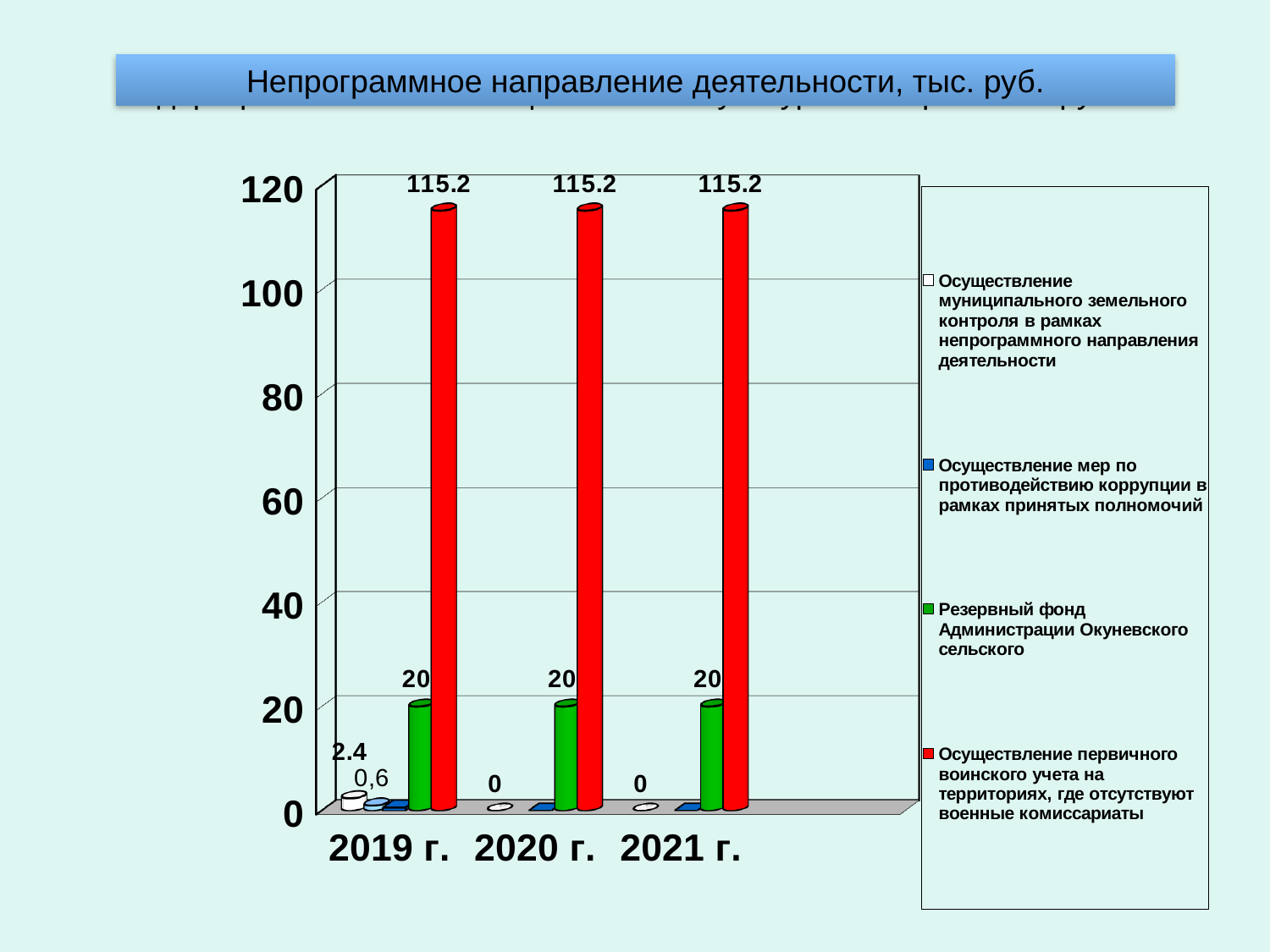
How many year categories are shown on the x axis? 3 How many series does the legend list? 4 What is the value for 'Осуществление первичного воинского учета на территориях, где отсутствуют военные комиссариаты' in 2019 г.? 115.2 What is the value for 'Резервный фонд Администрации Окуневского сельского' in 2021 г.? 20 Does the value for 'Осуществление первичного воинского учета на территориях, где отсутствуют военные комиссариаты' rise, fall or stay the same from 2019 г. to 2021 г.? Stays the same Which is larger in 2019 г.: the value for 'Резервный фонд Администрации Окуневского сельского' or the value for 'Осуществление муниципального земельного контроля в рамках непрограммного направления деятельности'? Резервный фонд Администрации Окуневского сельского What is the difference between the red series value and the green series value in 2021 г.? 95.2 What is the value for 'Осуществление муниципального земельного контроля в рамках непрограммного направления деятельности' in 2019 г.? 2.4 What is the value for 'Осуществление мер по противодействию коррупции в рамках принятых полномочий' in 2019 г.? 0,6 What kind of chart is shown on the slide? Bar chart Which series has the highest value in 2020 г.? Осуществление первичного воинского учета на территориях, где отсутствуют военные комиссариаты What is the title of the chart? Непрограммное направление деятельности, тыс. руб.